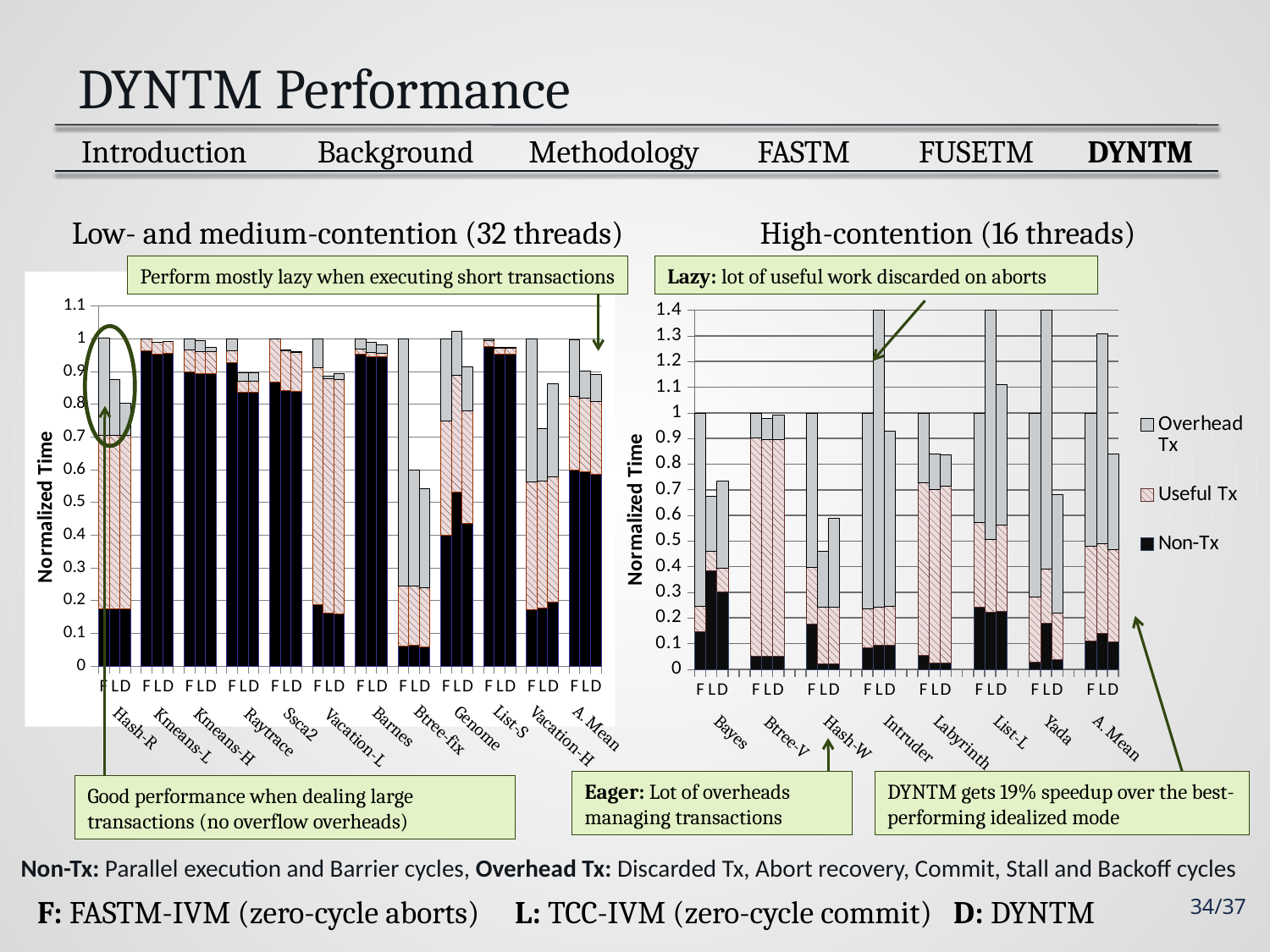
How many benchmark groups are shown along the x axis of the 'High-contention (16 threads)' chart? 8 In the 'High-contention (16 threads)' chart, is the total of the D bar for Intruder greater or less than 1? less In the 'High-contention (16 threads)' chart, is the total of the D bar for List-L greater or less than 1? greater In the 'Low- and medium-contention (32 threads)' chart, is the total of the L bar for Btree-fix greater or less than 0.7? less What is the y-axis title of the 'High-contention (16 threads)' chart? Normalized Time How many series does the legend list for the 'High-contention (16 threads)' chart? 3 How many benchmark groups are shown along the x axis of the 'Low- and medium-contention (32 threads)' chart? 12 In the 'Low- and medium-contention (32 threads)' chart, which is taller for Hash-R: the L bar or the D bar? L bar In the 'High-contention (16 threads)' chart, what is the total normalized time of the F bar for Bayes? 1 What kind of chart is the 'Low- and medium-contention (32 threads)' chart? Stacked bar chart In the 'High-contention (16 threads)' chart, which is taller for Hash-W: the L bar or the D bar? D bar